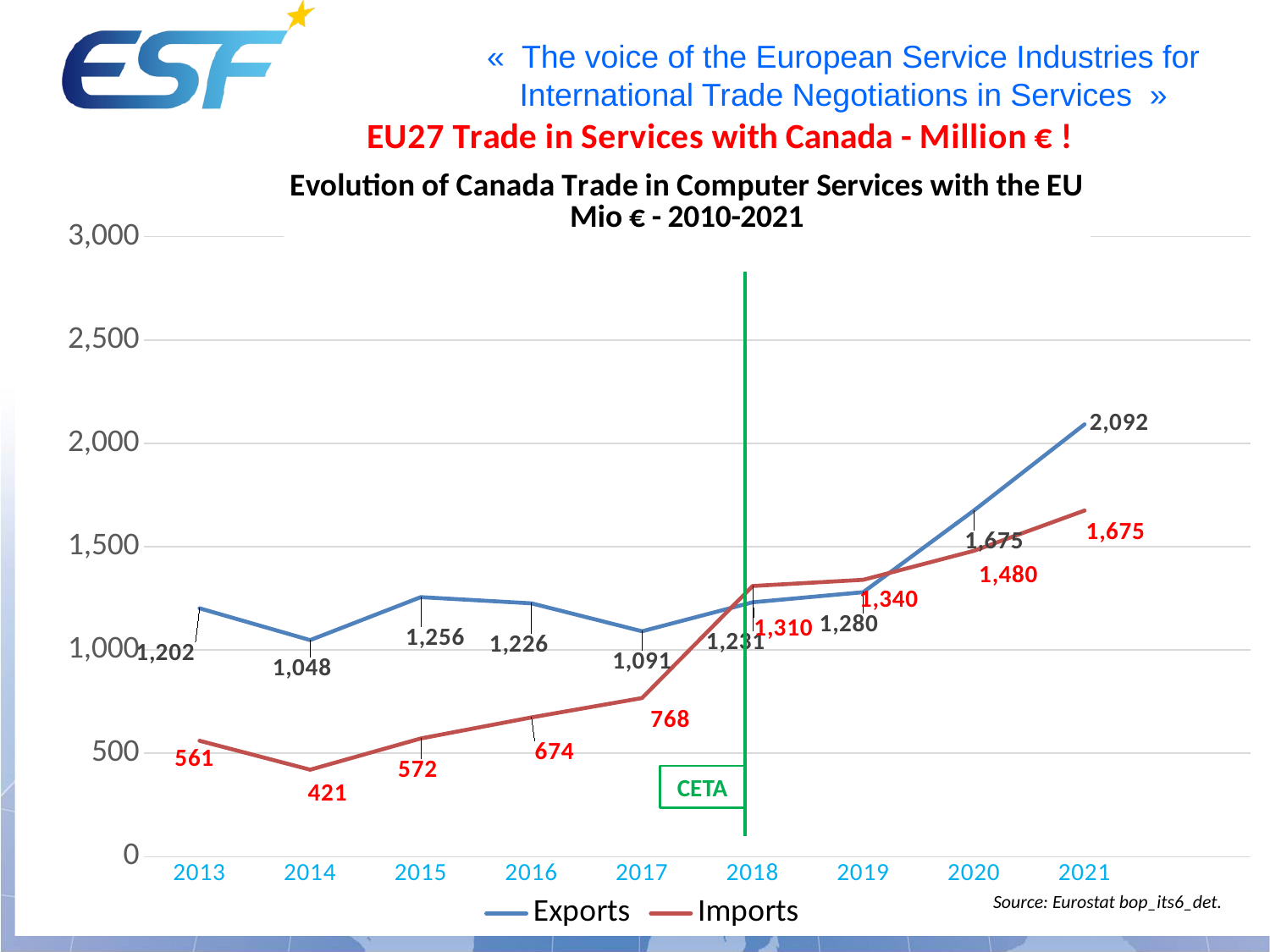
In which year are Exports highest? 2021 What is the value of Imports in 2014? 421 What is the value of Exports in 2017? 1,091 How many series does the legend list? 2 By how much did Imports increase from 2013 to 2017? 207 What is the value of Exports in 2021? 2,092 How many years are plotted on the x axis? 9 In 2018, which is larger, Exports or Imports? Imports What is the difference between Exports and Imports in 2021? 417 What kind of chart is shown? Line chart Do Imports rise or fall from 2018 to 2021? Rise In which year are Imports lowest? 2014